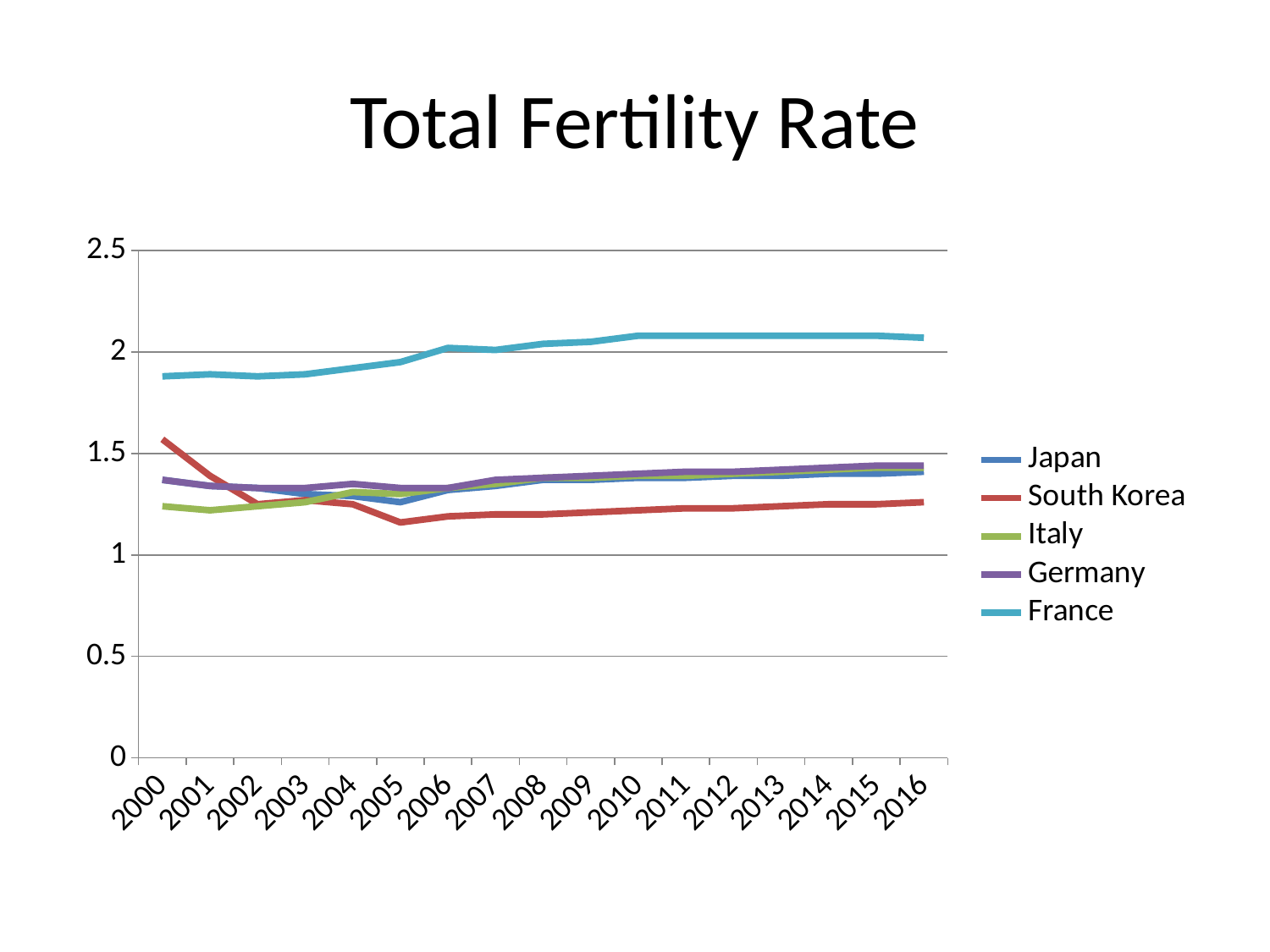
Is the value for France in 2000 greater or less than 2? less Does the value for South Korea rise or fall from 2000 to 2005? fall What kind of chart is shown on the slide? line chart How many years are shown along the x axis? 17 Does the value for France rise or fall from 2000 to 2016? rise What is the title of the chart? Total Fertility Rate Is the value for South Korea in 2005 greater or less than 1.5? less Is the value for France in 2010 greater or less than 2? greater Which is larger in 2005, the value for Germany or the value for South Korea? Germany Which country has the lowest total fertility rate in 2016? South Korea Which country has the highest total fertility rate in 2016? France How many series does the legend list? 5